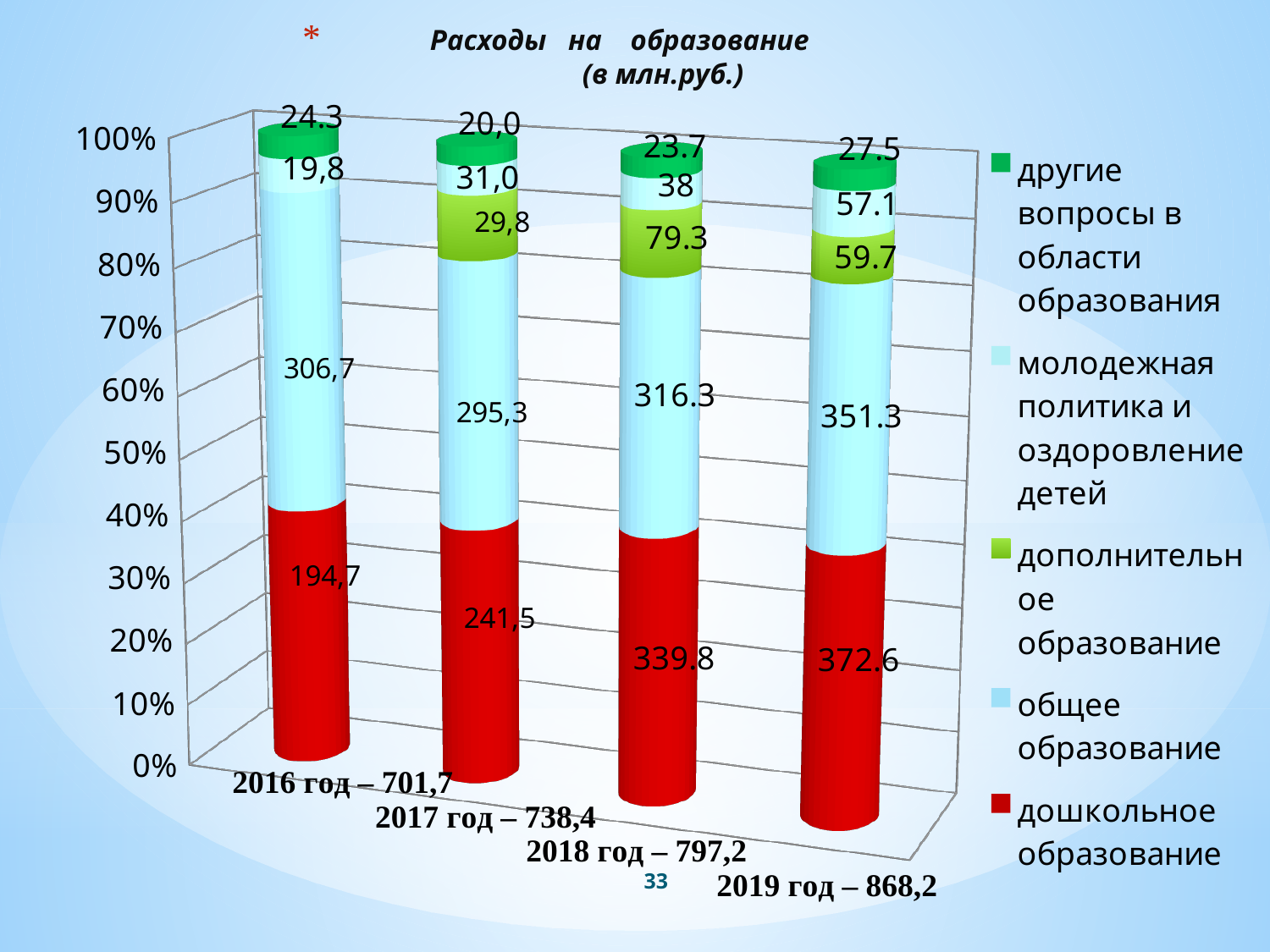
What is the value for общее образование in 2019 год? 351.3 How many series does the legend list? 5 What is the difference between дошкольное образование in 2019 год and in 2018 год? 32.8 What is the total for 2018 год as shown in the category label? 797,2 What is the value for дошкольное образование in 2016 год? 194,7 In which year is the value for другие вопросы в области образования the lowest? 2017 год What is the value for дополнительное образование in 2018 год? 79.3 Which is larger in 2017 год: дошкольное образование or общее образование? общее образование In which year is the value for дошкольное образование the highest? 2019 год How many years (categories) are shown on the x axis? 4 What is the value for молодежная политика и оздоровление детей in 2017 год? 31,0 What kind of chart is shown on the slide? stacked bar chart